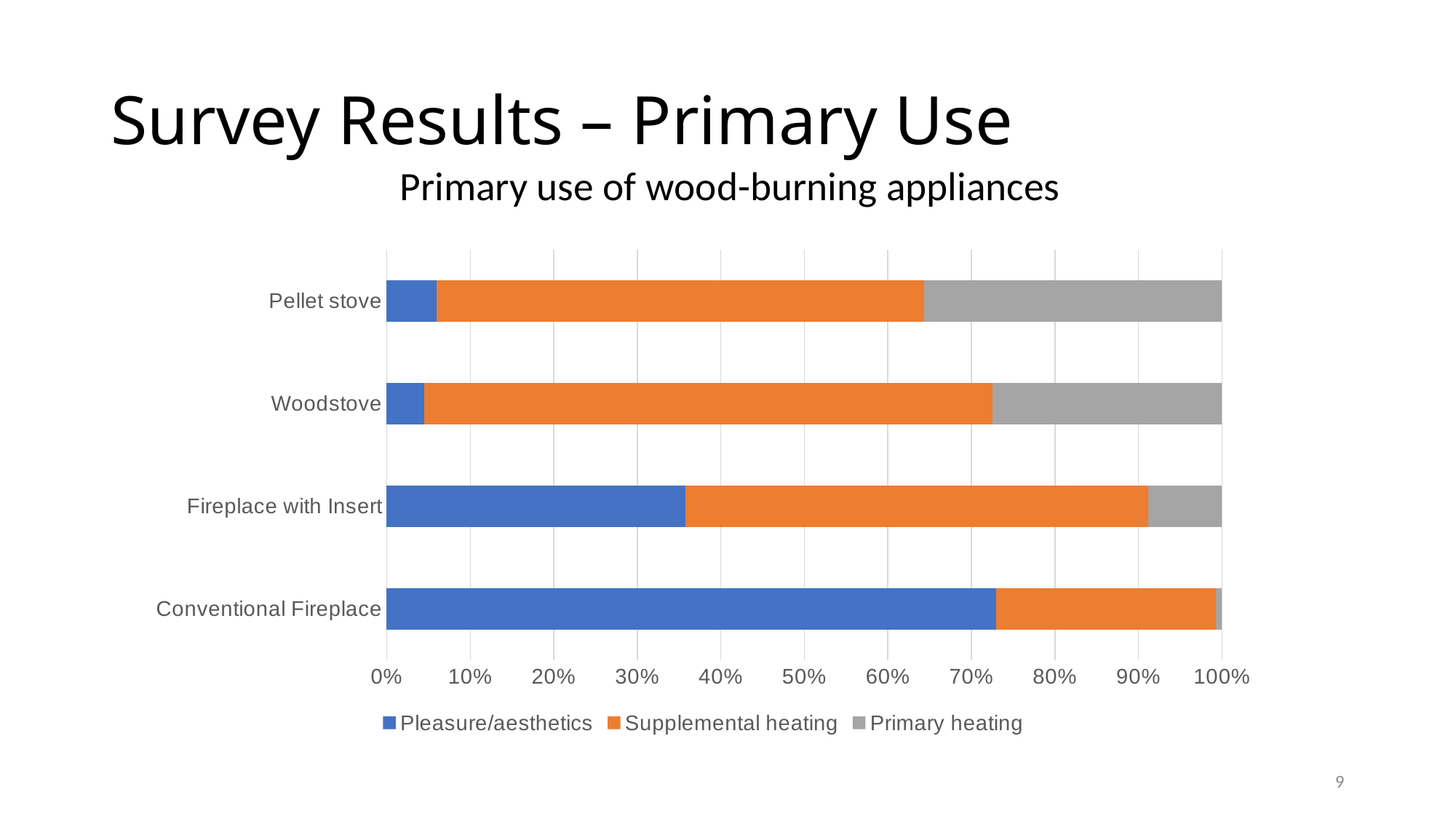
Which appliance has the smallest Primary heating share? Conventional Fireplace Which appliance has the largest Supplemental heating share? Woodstove What kind of chart is shown on the slide? Stacked bar chart Which has a larger Pleasure/aesthetics share, Fireplace with Insert or Woodstove? Fireplace with Insert Is the Pleasure/aesthetics share for Fireplace with Insert greater or less than 30%? greater Which appliance has the largest Pleasure/aesthetics share? Conventional Fireplace Is the Pleasure/aesthetics share for Conventional Fireplace greater or less than 70%? greater What is the title of the chart? Primary use of wood-burning appliances Which appliance has the largest Primary heating share? Pellet stove Is the Pleasure/aesthetics share for Pellet stove greater or less than 10%? less How many appliance categories are plotted on the chart? 4 How many series does the legend list? 3